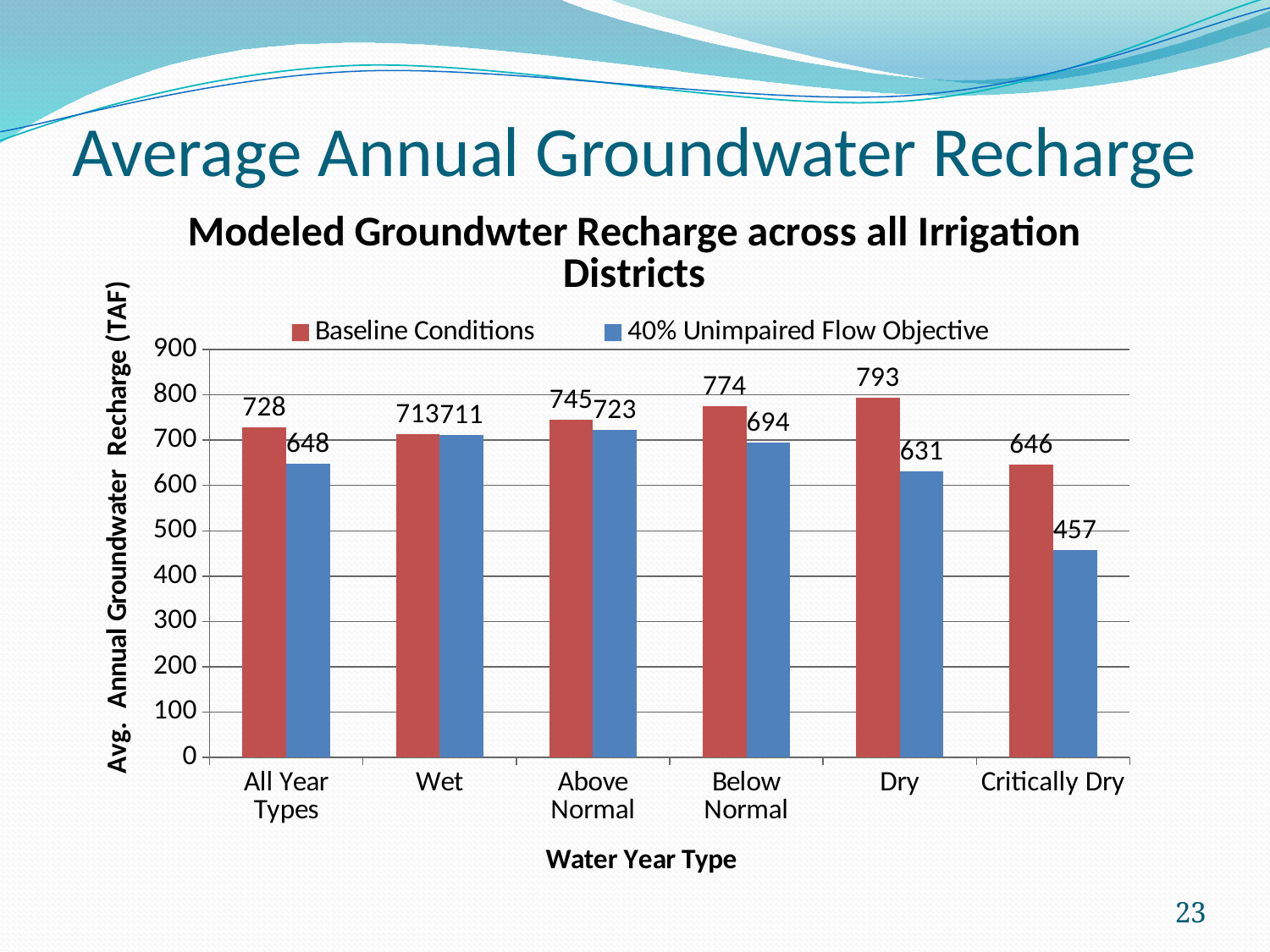
How many water year type categories are shown on the x axis? 6 What is the difference between the Baseline Conditions and 40% Unimpaired Flow Objective values for Dry? 162 What is the Baseline Conditions value for the Dry water year type? 793 What kind of chart is shown on the slide? Bar chart What is the difference between the Baseline Conditions and 40% Unimpaired Flow Objective values for Critically Dry? 189 What is the 40% Unimpaired Flow Objective value for Critically Dry? 457 What is the Baseline Conditions value for All Year Types? 728 Which water year type has the lowest 40% Unimpaired Flow Objective value? Critically Dry How many series does the legend list? 2 Which water year type has the highest Baseline Conditions value? Dry Which is larger for Below Normal: Baseline Conditions or 40% Unimpaired Flow Objective? Baseline Conditions What is the label of the y axis? Avg. Annual Groundwater Recharge (TAF)